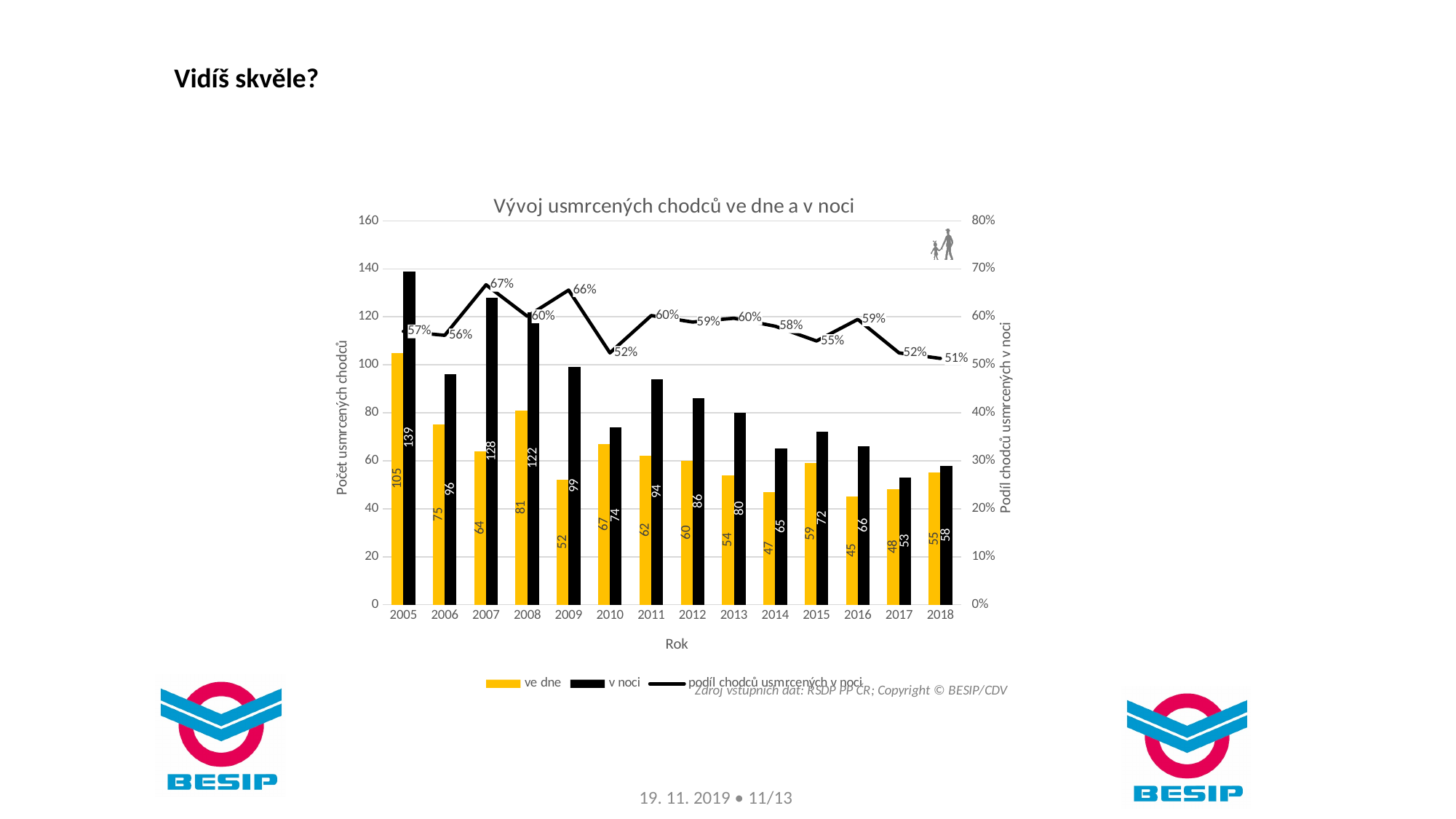
Which year has the lowest value for 've dne'? 2016 What is the value for 've dne' in 2009? 52 What is the difference between the 'v noci' and 've dne' values in 2007? 64 Which is larger in 2010, the 've dne' value or the 'v noci' value? v noci Which year has the highest value for 'v noci'? 2005 How many years are shown on the x axis? 14 What is the value for 'v noci' in 2005? 139 What share of pedestrians killed at night ('podíl chodců usmrcených v noci') is shown for 2007? 67% What is the title of the chart? Vývoj usmrcených chodců ve dne a v noci How many series does the legend list? 3 What kind of chart is this? Combined bar and line chart Does the 'v noci' series generally rise or fall from 2005 to 2018? Fall